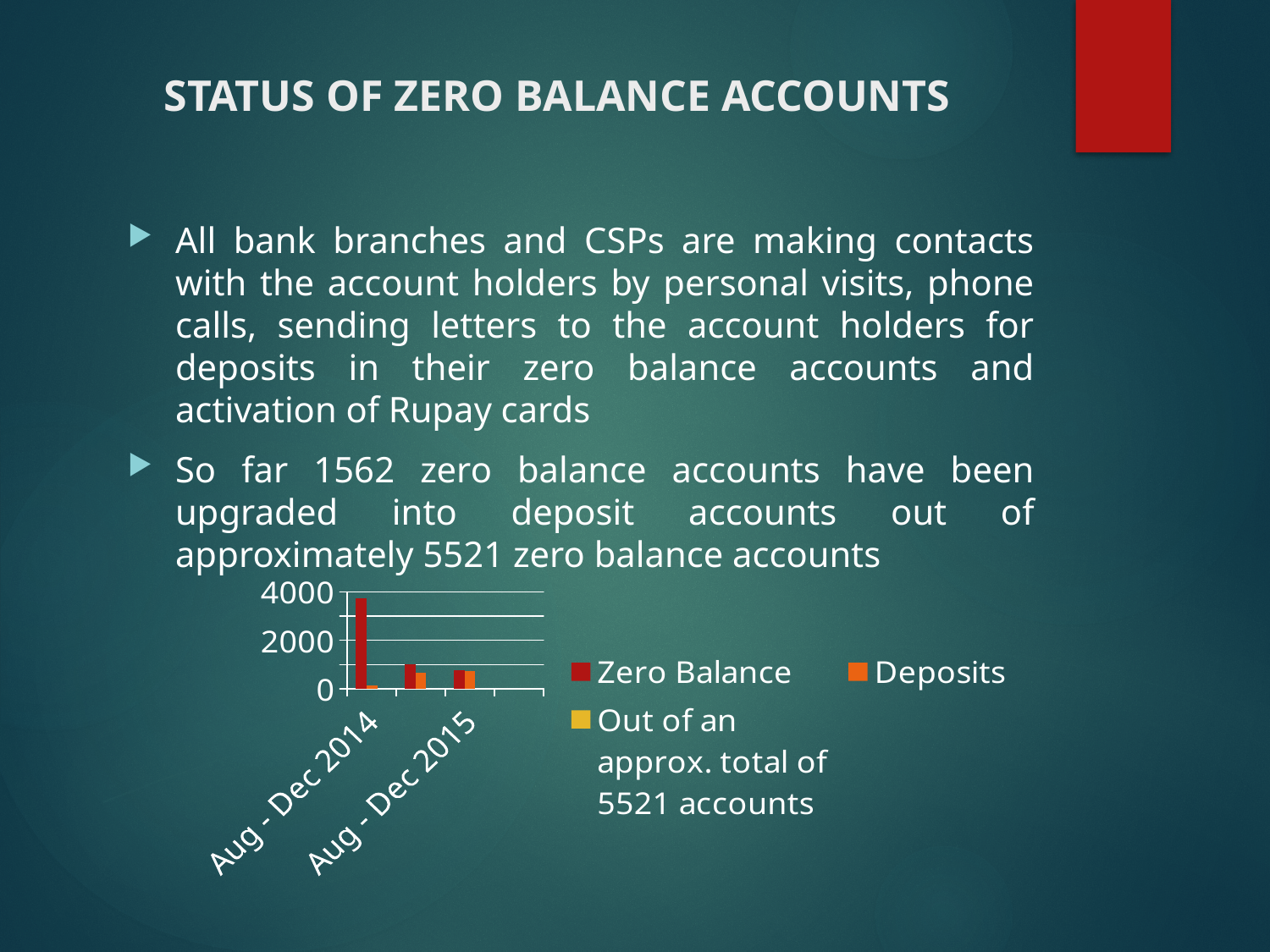
What is the highest value shown on the chart's vertical axis? 4000 Which is larger: the Zero Balance value for Aug - Dec 2014 or for Aug - Dec 2015? Aug - Dec 2014 Do the Zero Balance values rise or fall from Aug - Dec 2014 to Aug - Dec 2015? fall What colour are the Zero Balance bars in the chart? red What kind of chart is shown on the slide? bar chart Which category has the highest Zero Balance value? Aug - Dec 2014 Is the Zero Balance value for Aug - Dec 2015 greater or less than 2000? less Is the Zero Balance value for Aug - Dec 2014 greater or less than 2000? greater Is the Deposits value for Aug - Dec 2014 greater or less than 2000? less In Aug - Dec 2014, which is larger: Zero Balance or Deposits? Zero Balance How many series does the chart's legend list? 3